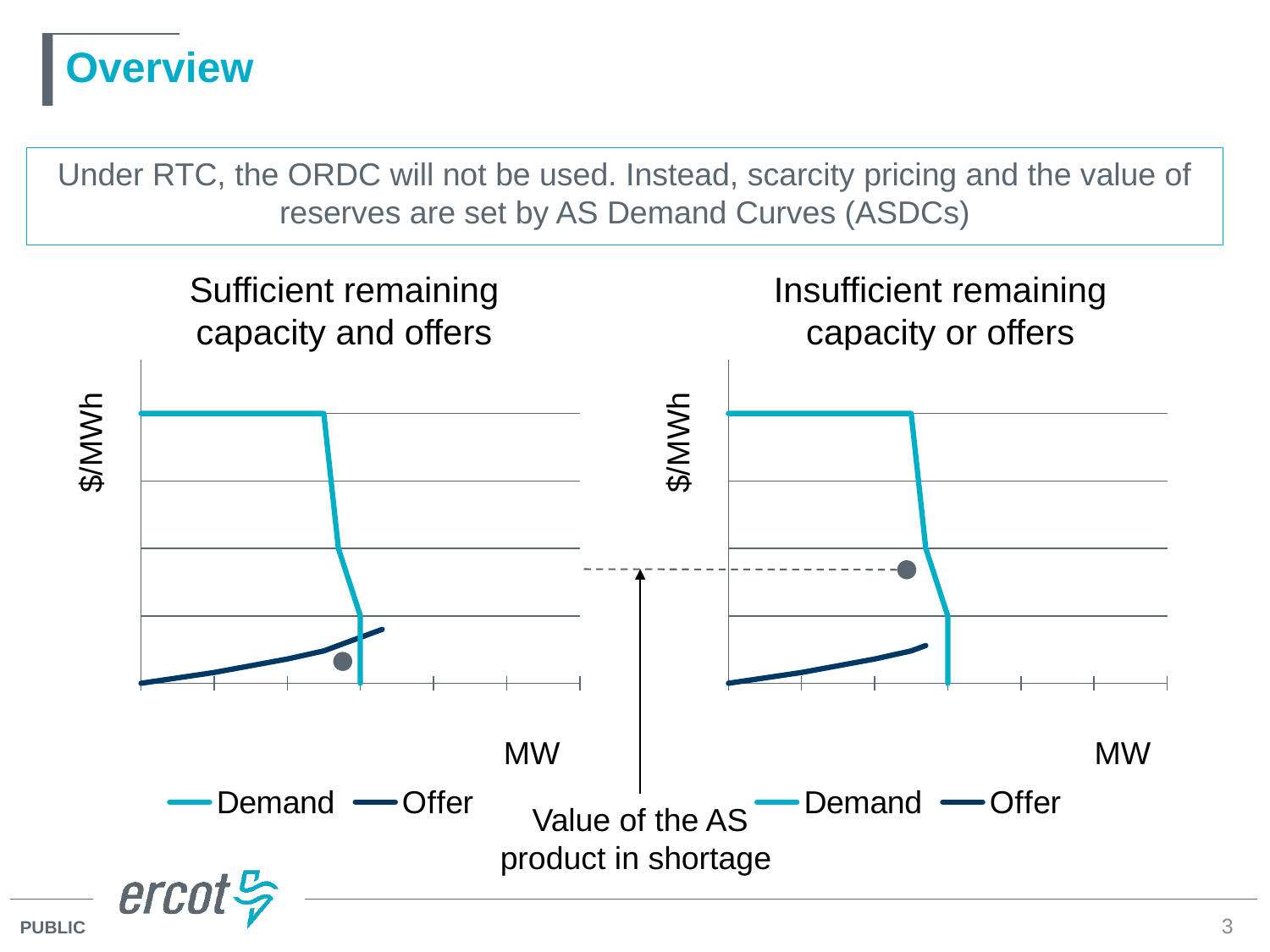
How many series does the legend of the 'Sufficient remaining capacity and offers' chart list? 2 What are the two series named in the legend of the 'Insufficient remaining capacity or offers' chart? Demand and Offer In the 'Sufficient remaining capacity and offers' chart, does the Offer series rise or fall as MW increases? rise In the 'Sufficient remaining capacity and offers' chart, does the Demand series rise or fall as MW increases? fall In the 'Insufficient remaining capacity or offers' chart, does the Demand series rise or fall as MW increases? fall What kind of chart is the 'Sufficient remaining capacity and offers' chart? line chart What is the y-axis label of the 'Sufficient remaining capacity and offers' chart? $/MWh What kind of chart is the 'Insufficient remaining capacity or offers' chart? line chart How many series does the legend of the 'Insufficient remaining capacity or offers' chart list? 2